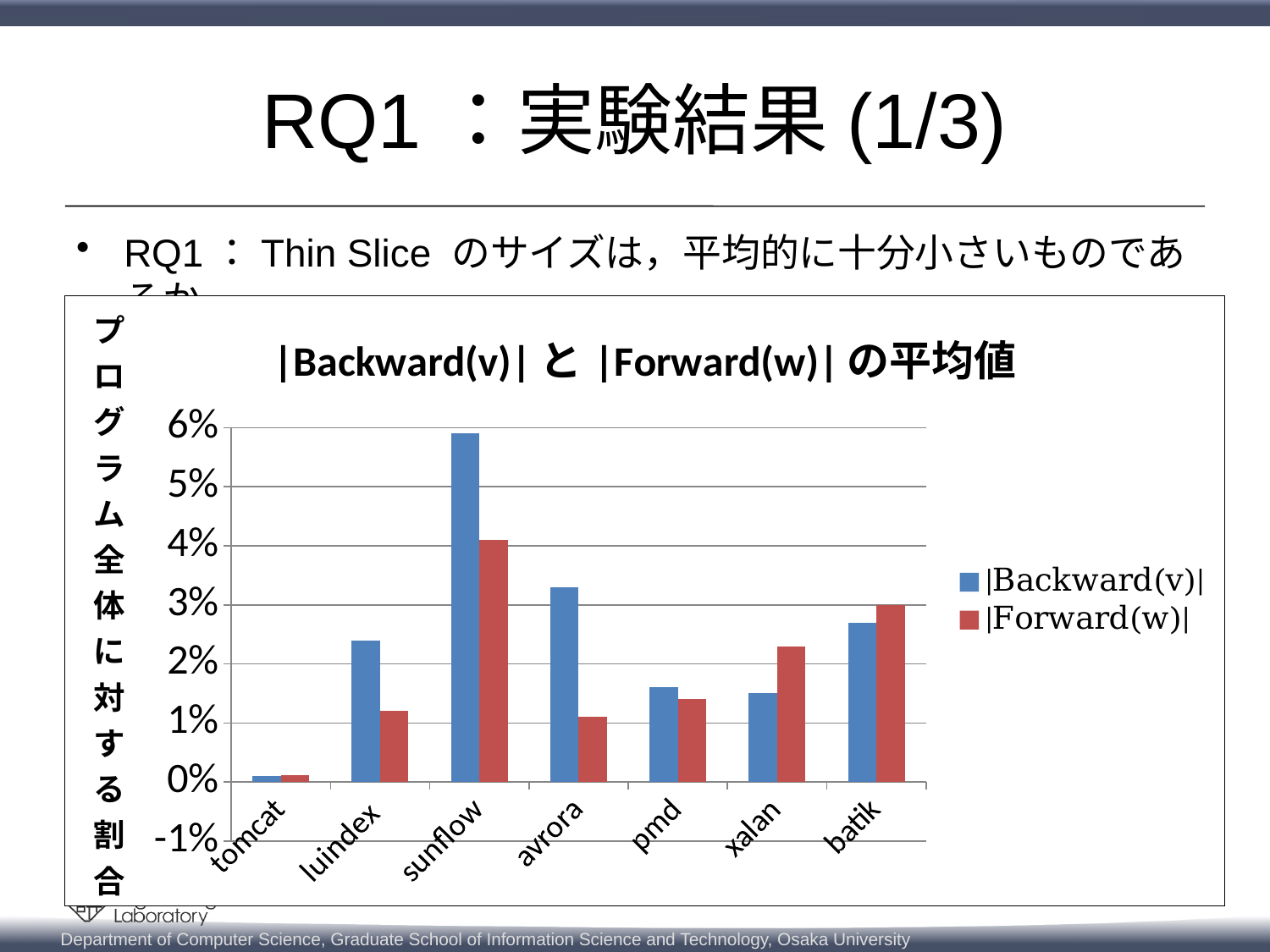
Is the |Backward(v)| value for pmd greater or less than 2%? less Is the |Backward(v)| value for sunflow greater or less than 5%? greater Which program has the lowest |Backward(v)| value? tomcat Which program has the highest |Forward(w)| value? sunflow Is the |Forward(w)| value for xalan greater or less than 2%? greater Which program has the highest |Backward(v)| value? sunflow How many programs (categories) are shown on the x axis of the chart? 7 What kind of chart is shown on the slide? bar chart How many series does the chart legend list? 2 For xalan, which is larger: |Backward(v)| or |Forward(w)|? |Forward(w)| What is the title of the chart? |Backward(v)| と |Forward(w)| の平均値